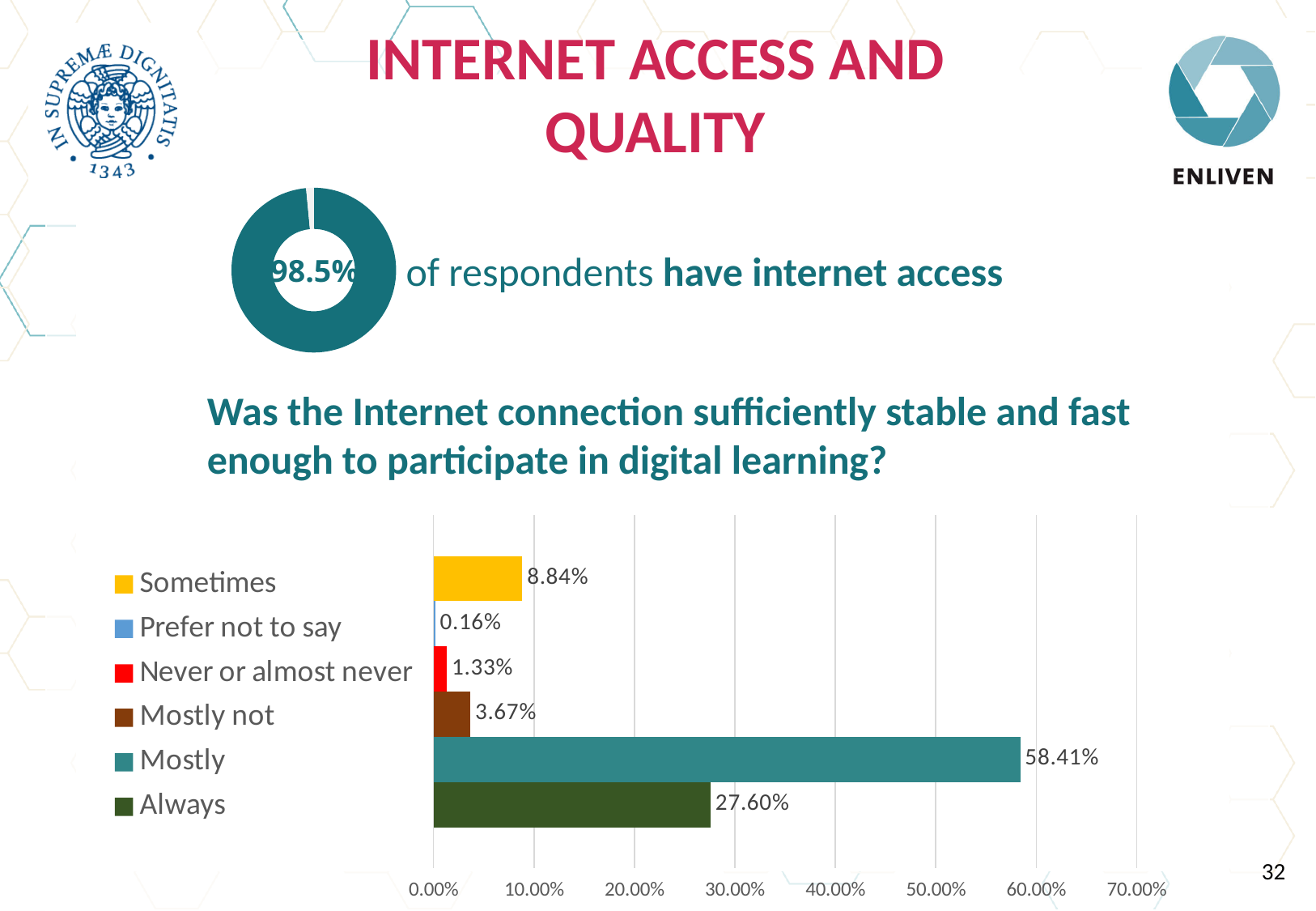
In the bar chart about Internet connection stability, what is the difference between the "Mostly" and "Always" percentages? 30.81% What type of chart is used to show the responses about Internet connection stability? Bar chart In the bar chart about Internet connection stability, what percentage of respondents answered "Mostly"? 58.41% In the bar chart about Internet connection stability, what is the value for "Prefer not to say"? 0.16% How many response categories are shown in the bar chart about Internet connection stability? 6 In the bar chart about Internet connection stability, which response has the lowest percentage? Prefer not to say In the bar chart about Internet connection stability, what is the value for "Never or almost never"? 1.33% In the bar chart about Internet connection stability, what percentage of respondents answered "Always"? 27.60% In the bar chart about Internet connection stability, which is larger: "Sometimes" or "Mostly not"? Sometimes According to the donut chart at the top of the slide, what percentage of respondents have internet access? 98.5% In the bar chart about Internet connection stability, is the value for "Mostly" greater or less than 50.00%? greater In the bar chart about Internet connection stability, which response has the highest percentage? Mostly